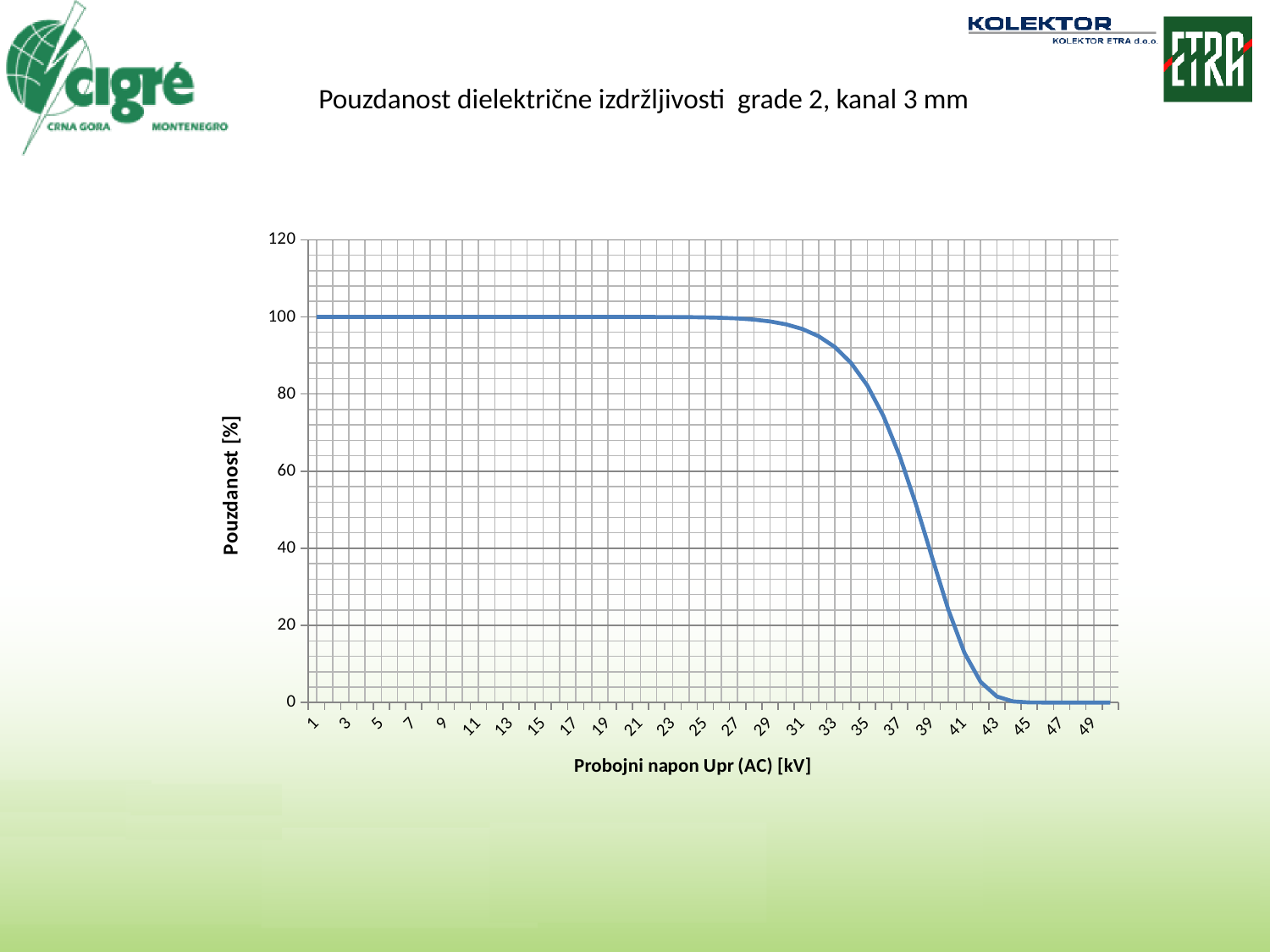
What is the value of the curve at a breakdown voltage of 49 kV? 0 What is the highest tick value shown on the y axis? 120 Is the value at 45 kV greater or less than 20? less Is the value at 21 kV greater or less than 80? greater What kind of chart is shown on the slide? line chart What is the value of the curve at a breakdown voltage of 1 kV? 100 Is the value at 41 kV greater or less than 40? less What is the label of the x axis? Probojni napon Upr (AC) [kV] Does the reliability rise or fall as the breakdown voltage increases along the x axis? fall What is the title of the chart? Pouzdanost dielektrične izdržljivosti grade 2, kanal 3 mm